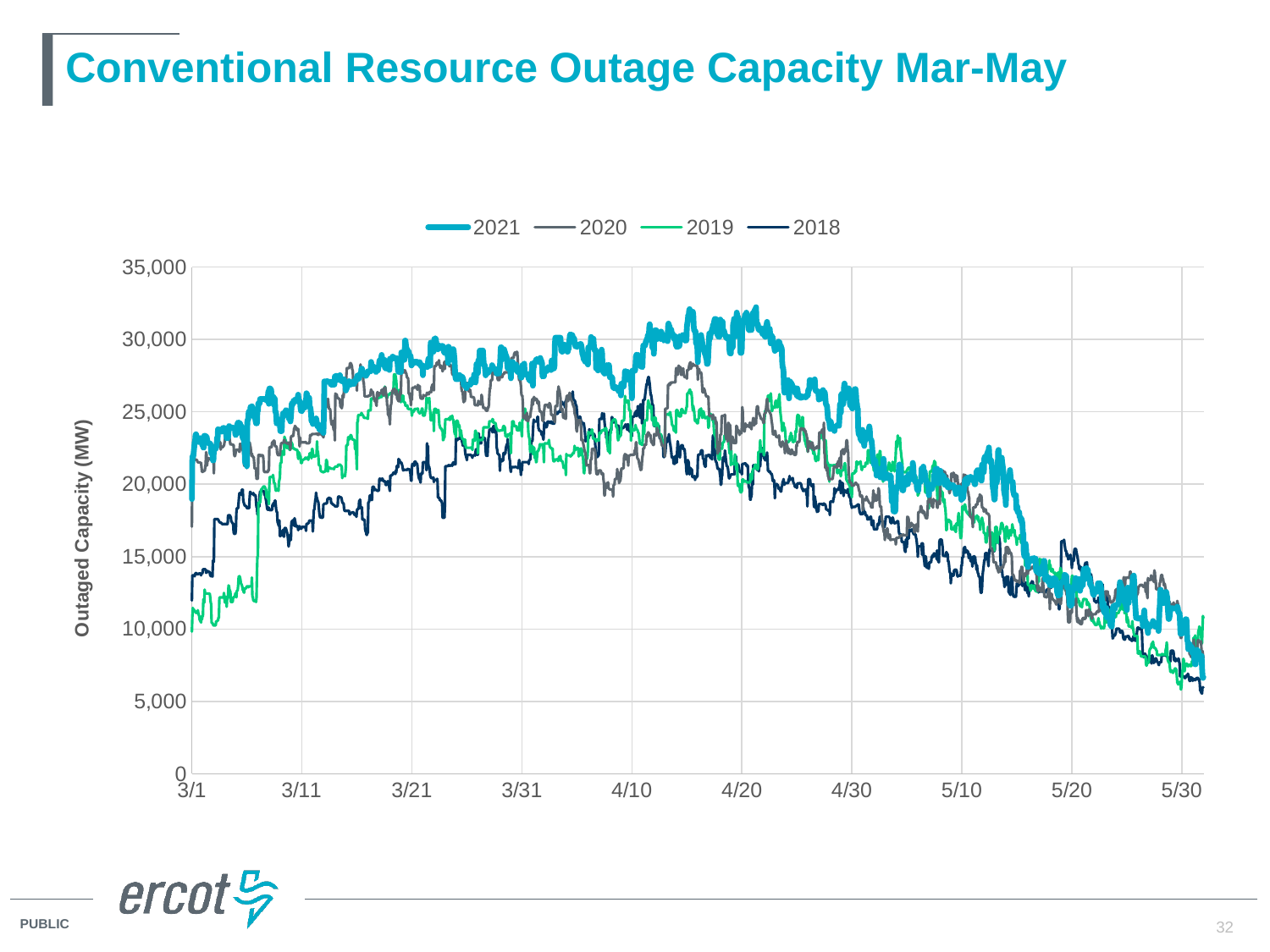
Is the value for the 2018 series at 3/1 greater or less than 15,000? less What is the highest value shown on the vertical axis? 35,000 Which series has the highest outaged capacity around 4/20? 2021 Do the values of the 2021 series rise or fall between 4/20 and 5/30? fall How many series does the legend list? 4 Is the peak value of the 2021 series around 4/20 greater or less than 30,000? greater Do the values of the 2021 series rise or fall between 3/1 and 4/20? rise Is the value for the 2019 series at 3/1 greater or less than 15,000? less What is the label of the vertical axis? Outaged Capacity (MW) What kind of chart is shown on the slide? Line chart Which years are listed in the chart legend? 2021, 2020, 2019, 2018